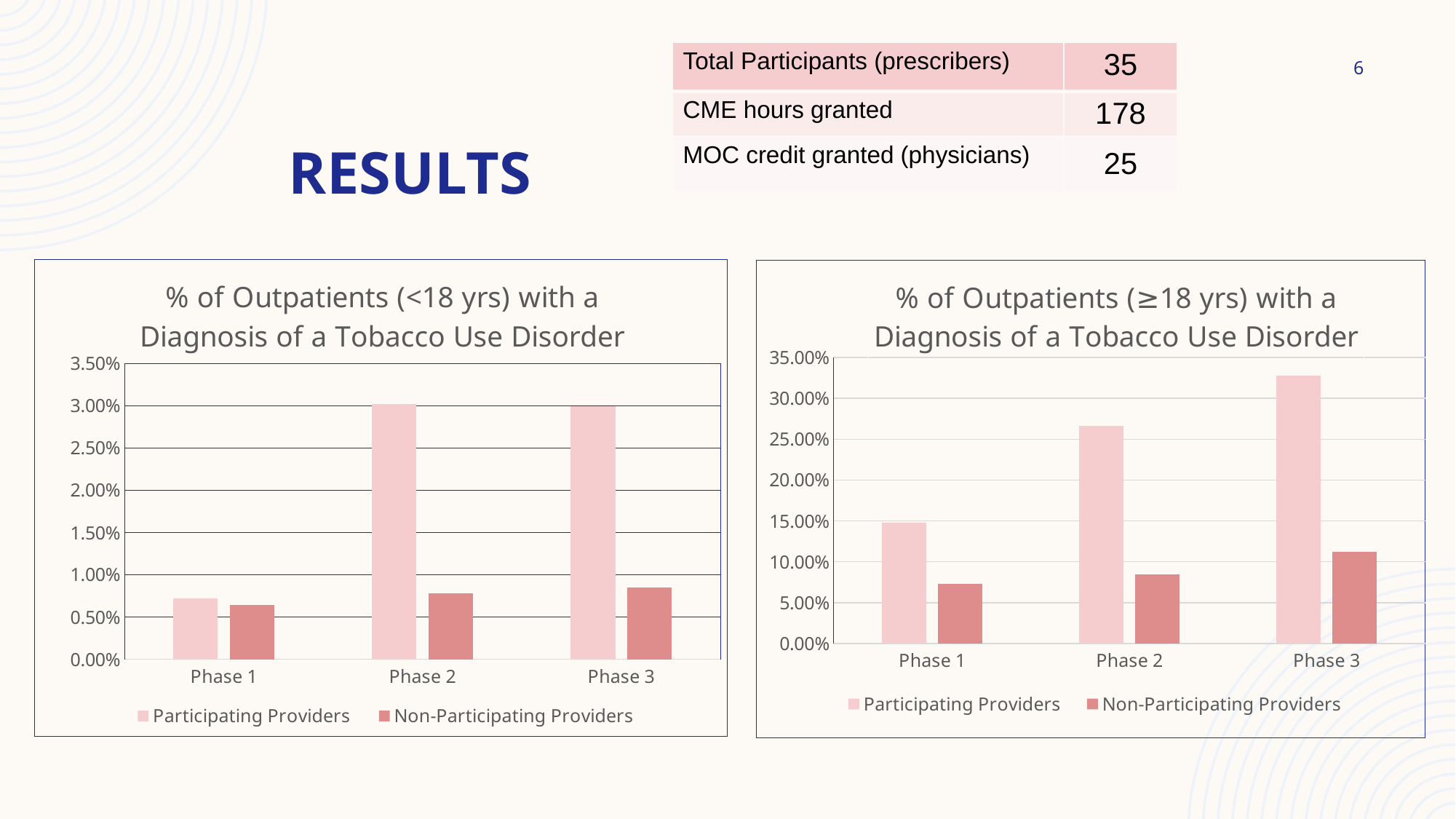
How many series does the legend list in the '% of Outpatients (≥18 yrs) with a Diagnosis of a Tobacco Use Disorder' chart? 2 What kind of chart is the '% of Outpatients (<18 yrs) with a Diagnosis of a Tobacco Use Disorder' chart? Bar chart In the '% of Outpatients (≥18 yrs) with a Diagnosis of a Tobacco Use Disorder' chart, do the values for Participating Providers rise or fall from Phase 1 to Phase 3? rise In the '% of Outpatients (<18 yrs) with a Diagnosis of a Tobacco Use Disorder' chart, which phase has the lowest value for Participating Providers? Phase 1 In the '% of Outpatients (≥18 yrs) with a Diagnosis of a Tobacco Use Disorder' chart, which phase has the highest value for Participating Providers? Phase 3 In the '% of Outpatients (<18 yrs) with a Diagnosis of a Tobacco Use Disorder' chart, is the value for Non-Participating Providers in Phase 3 greater or less than 1.00%? less In the '% of Outpatients (≥18 yrs) with a Diagnosis of a Tobacco Use Disorder' chart, which is larger in Phase 2: Participating Providers or Non-Participating Providers? Participating Providers In the '% of Outpatients (≥18 yrs) with a Diagnosis of a Tobacco Use Disorder' chart, is the value for Participating Providers in Phase 3 greater or less than 30.00%? greater How many phases are shown on the x axis of the '% of Outpatients (<18 yrs) with a Diagnosis of a Tobacco Use Disorder' chart? 3 In the '% of Outpatients (≥18 yrs) with a Diagnosis of a Tobacco Use Disorder' chart, is the value for Non-Participating Providers in Phase 2 greater or less than 10.00%? less In the '% of Outpatients (≥18 yrs) with a Diagnosis of a Tobacco Use Disorder' chart, which phase has the lowest value for Non-Participating Providers? Phase 1